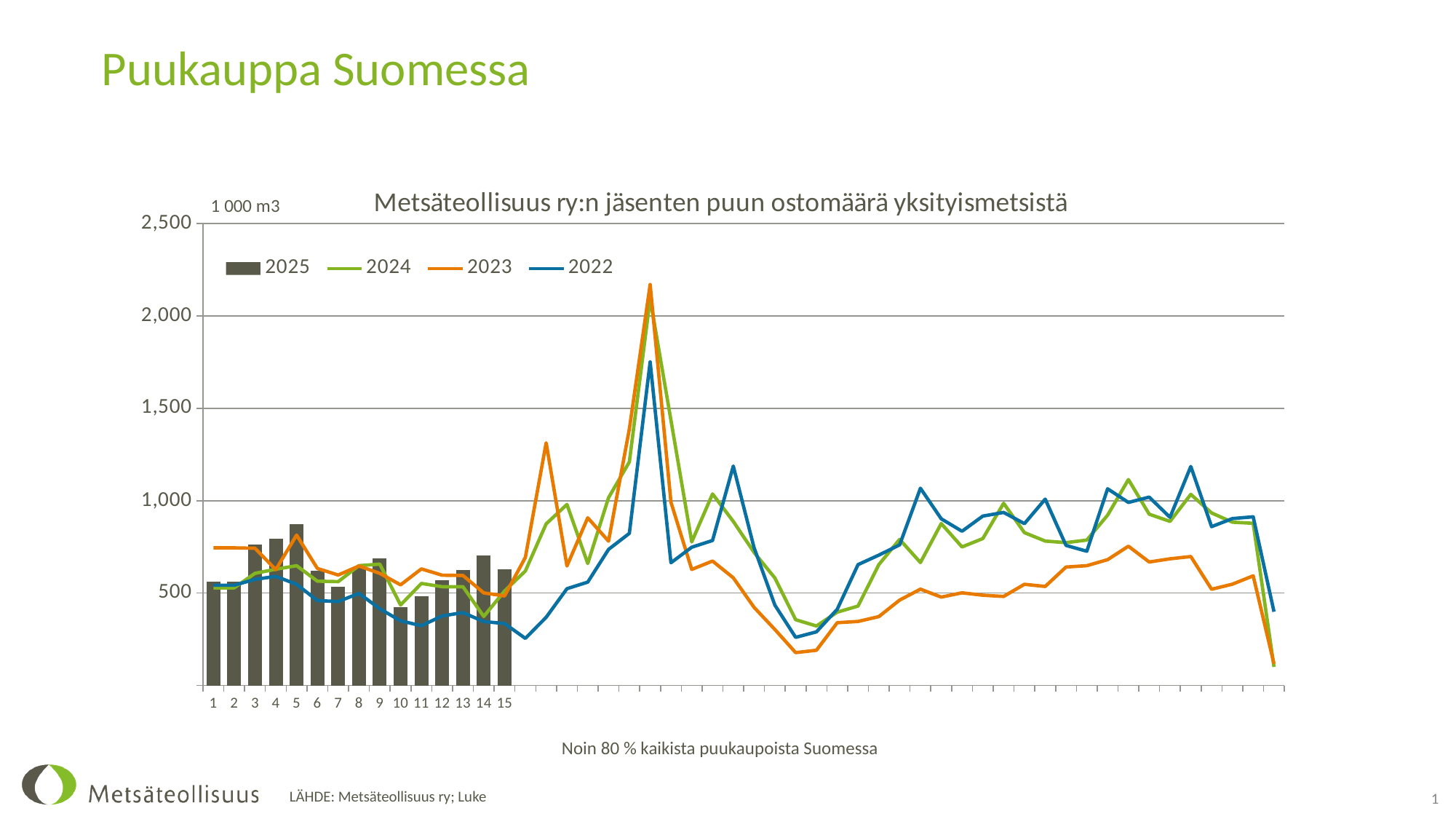
How many bars are plotted for the 2025 series? 15 Do the 2025 bars rise or fall from week 5 to week 10? fall Which series is shown as bars rather than a line? 2025 Is the 2025 value for week 10 greater or less than 500? less Is the highest point of the 2023 line greater or less than 2,000? greater What kind of chart is this? Combined bar and line chart Which week has the highest 2025 bar? 5 Is the highest point of the 2022 line greater or less than 2,000? less How many series does the chart legend list? 4 Which is larger, the 2025 bar for week 5 or the 2025 bar for week 10? Week 5 What is the title of the chart? Metsäteollisuus ry:n jäsenten puun ostomäärä yksityismetsistä